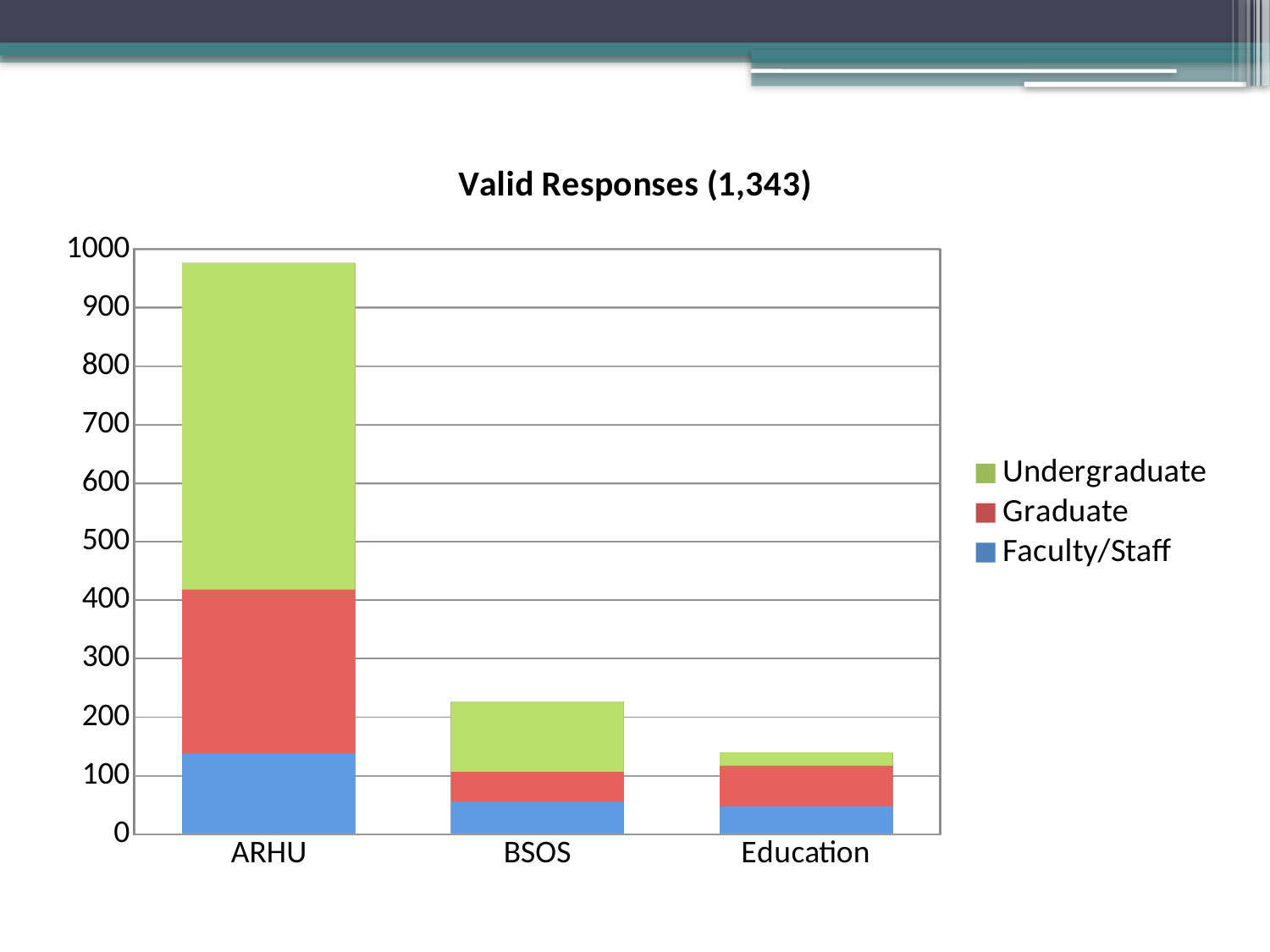
Which category has the tallest stacked bar? ARHU Which has a larger total bar, ARHU or BSOS? ARHU Which category has the shortest stacked bar? Education Which series is shown in green in the legend? Undergraduate How many categories are shown on the x axis? 3 How many series does the legend list? 3 Is the total bar for Education greater or less than 200? less What kind of chart is shown on the slide? stacked bar chart Is the total bar for BSOS greater or less than 300? less What is the title of the chart? Valid Responses (1,343) Is the Faculty/Staff segment for ARHU greater or less than 100? greater